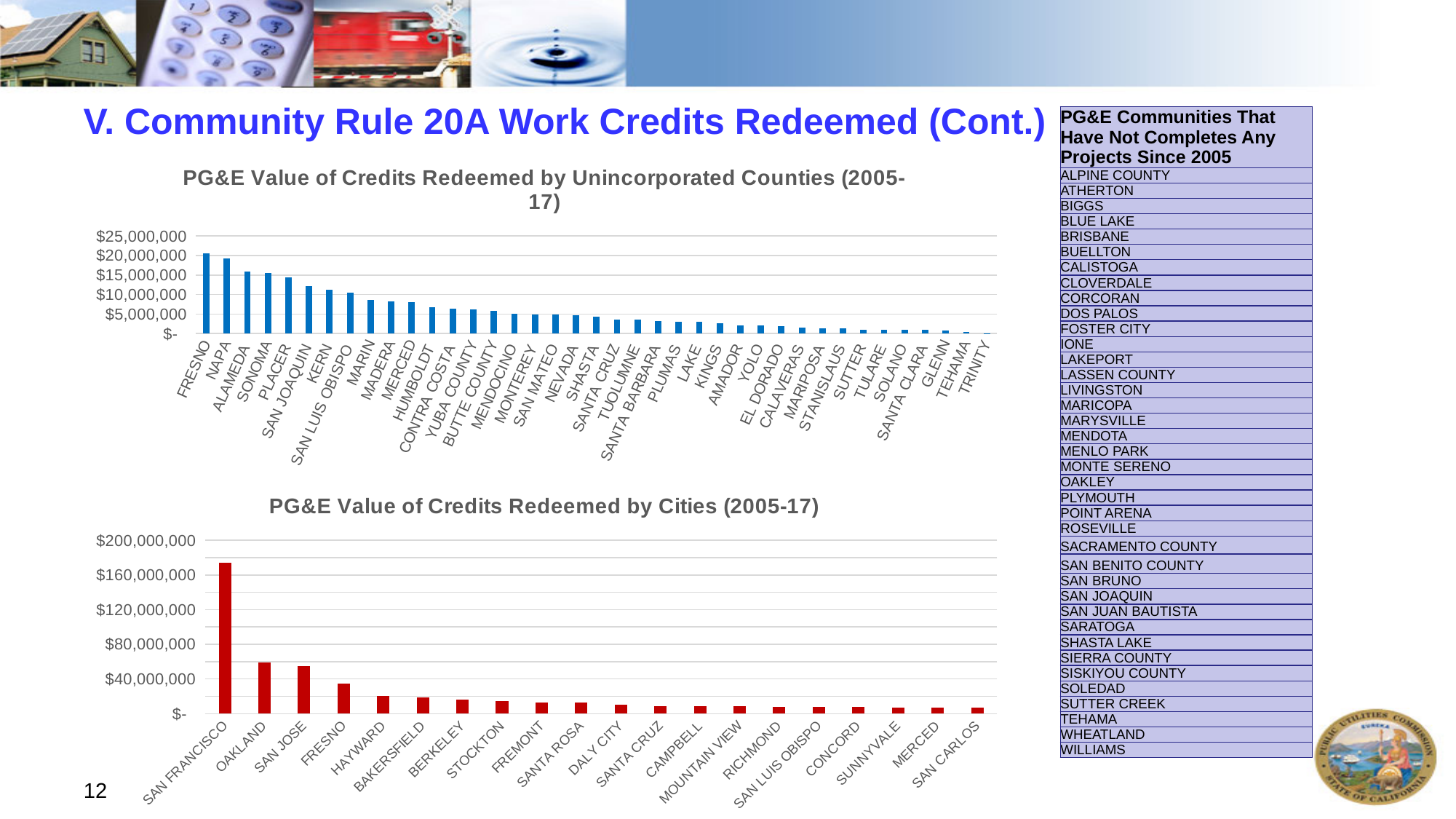
In the 'PG&E Value of Credits Redeemed by Cities (2005-17)' chart, is the value for FRESNO greater or less than $40,000,000? less In the 'PG&E Value of Credits Redeemed by Cities (2005-17)' chart, is the value for SAN FRANCISCO greater or less than $160,000,000? greater What colour are the bars in the 'PG&E Value of Credits Redeemed by Cities (2005-17)' chart? red In the 'PG&E Value of Credits Redeemed by Cities (2005-17)' chart, which is larger, the value for OAKLAND or the value for FRESNO? OAKLAND What type of chart is the 'PG&E Value of Credits Redeemed by Cities (2005-17)' chart? bar chart In the 'PG&E Value of Credits Redeemed by Unincorporated Counties (2005-17)' chart, is the value for FRESNO greater or less than $15,000,000? greater In the 'PG&E Value of Credits Redeemed by Unincorporated Counties (2005-17)' chart, which county has the lowest value? TRINITY In the 'PG&E Value of Credits Redeemed by Cities (2005-17)' chart, do the values rise or fall from left to right along the x axis? fall In the 'PG&E Value of Credits Redeemed by Unincorporated Counties (2005-17)' chart, which county has the highest value? FRESNO In the 'PG&E Value of Credits Redeemed by Cities (2005-17)' chart, how many cities are shown? 20 In the 'PG&E Value of Credits Redeemed by Cities (2005-17)' chart, which city has the highest value? SAN FRANCISCO